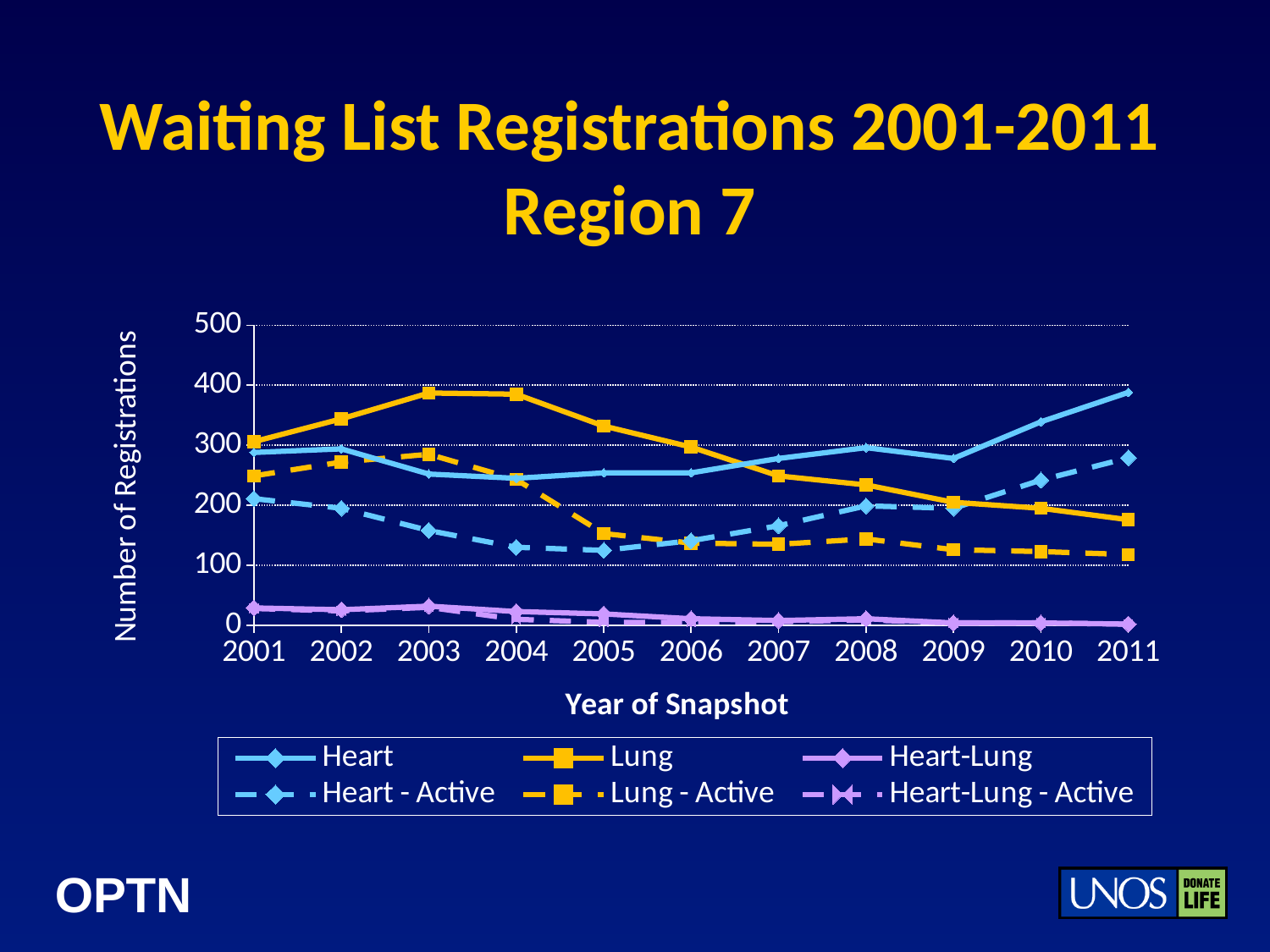
How many series does the legend list? 6 How many years are plotted along the x axis? 11 In which year is the Lung series at its lowest? 2011 What kind of chart is shown on the slide? line chart In 2011, which is larger, Heart or Lung? Heart Does the Lung series rise or fall from 2004 to 2011? fall Is the value for Lung in 2011 greater or less than 200? less Is the value for Lung in 2003 greater or less than 300? greater What is the label of the y axis? Number of Registrations In which year is the Heart series at its highest? 2011 Is the value for Heart-Lung in 2001 greater or less than 100? less